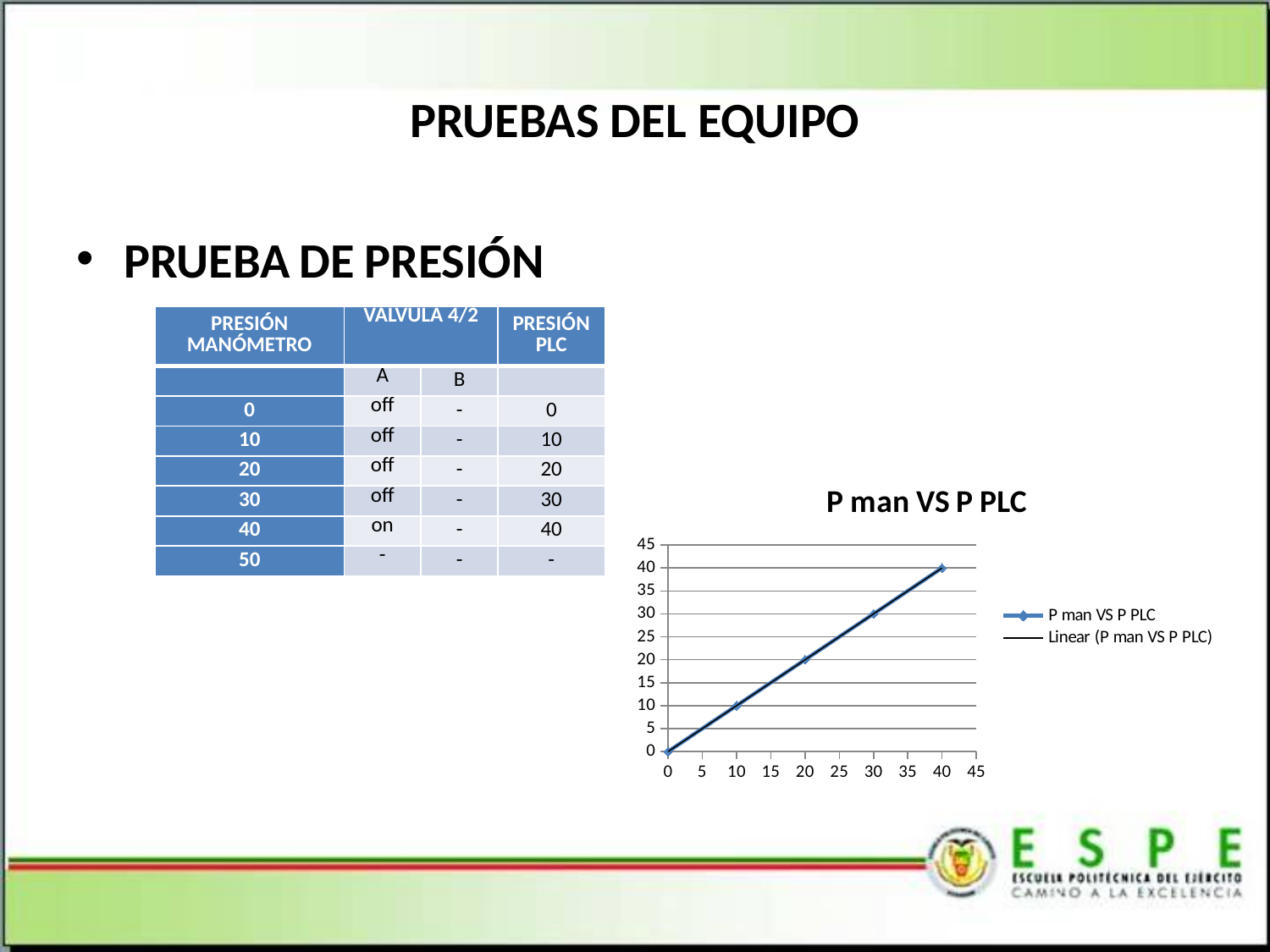
On the chart, what is the y value of the point at x = 0? 0 Do the plotted values rise or fall as x increases along the chart? rise On the chart, what is the difference between the y value at x = 40 and the y value at x = 10? 30 On the chart, is the y value at x = 30 larger or smaller than the y value at x = 20? larger What kind of chart is shown on the slide? line chart How many data points are plotted on the chart? 5 On the chart, what is the y value of the point at x = 40? 40 On the chart, what is the y value of the point at x = 20? 20 Which x value on the chart has the lowest y value? 0 How many entries does the legend of the chart list? 2 What is the title of the chart on the slide? P man VS P PLC Which x value on the chart has the highest y value? 40